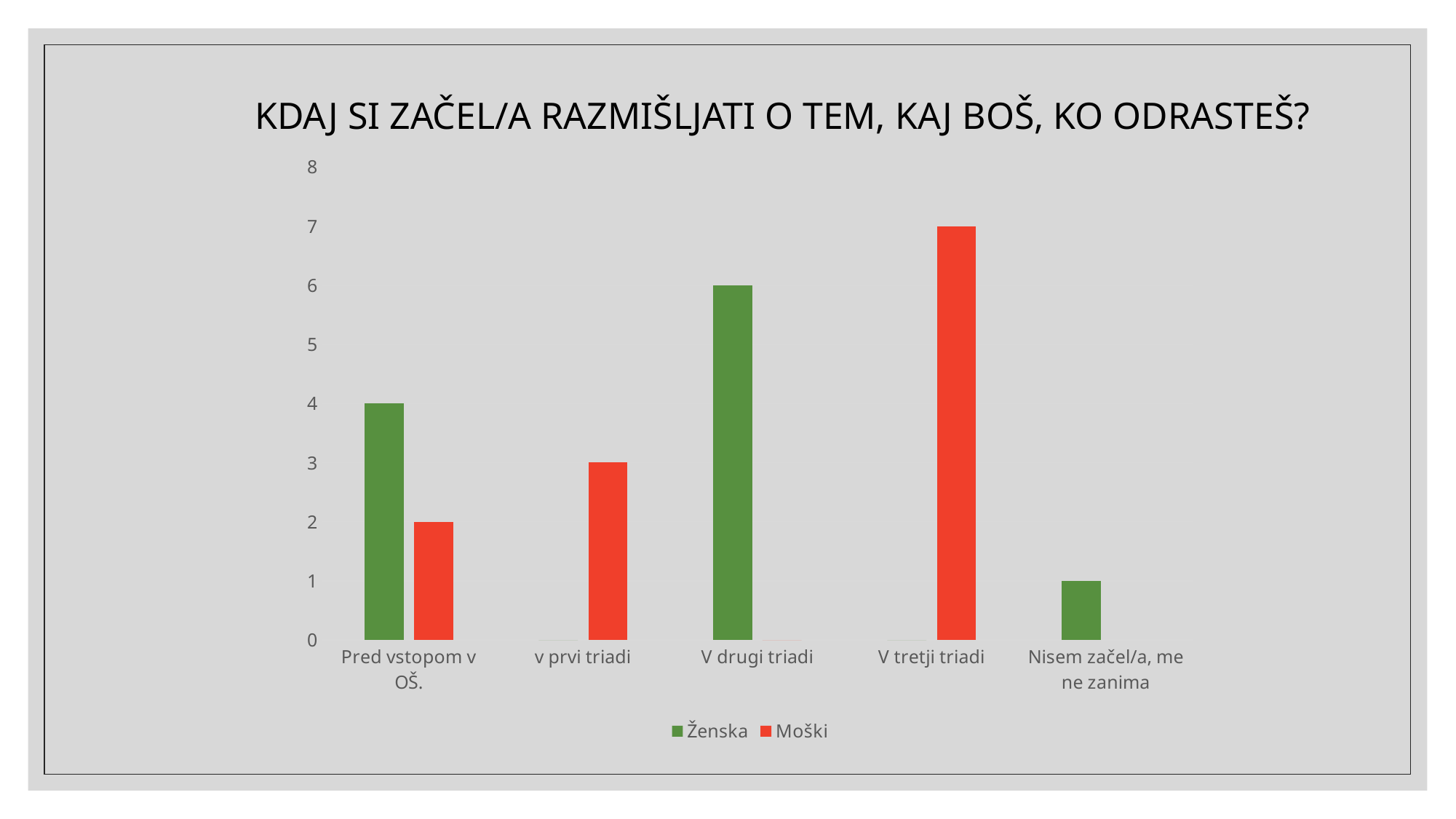
What is the value for Moški in the category 'V tretji triadi'? 7 How many categories are shown on the x axis? 5 What is the difference between the Ženska and Moški values in the category 'Pred vstopom v OŠ.'? 2 In the category 'Pred vstopom v OŠ.', which series has the larger value, Ženska or Moški? Ženska How many series does the legend list? 2 Which category has the highest value for Moški? V tretji triadi Which category has the highest value for Ženska? V drugi triadi What is the value for Ženska in the category 'V drugi triadi'? 6 What is the value for Ženska in the category 'Pred vstopom v OŠ.'? 4 What kind of chart is shown on the slide? bar chart Which colour represents the Moški series? red What is the value for Moški in the category 'v prvi triadi'? 3